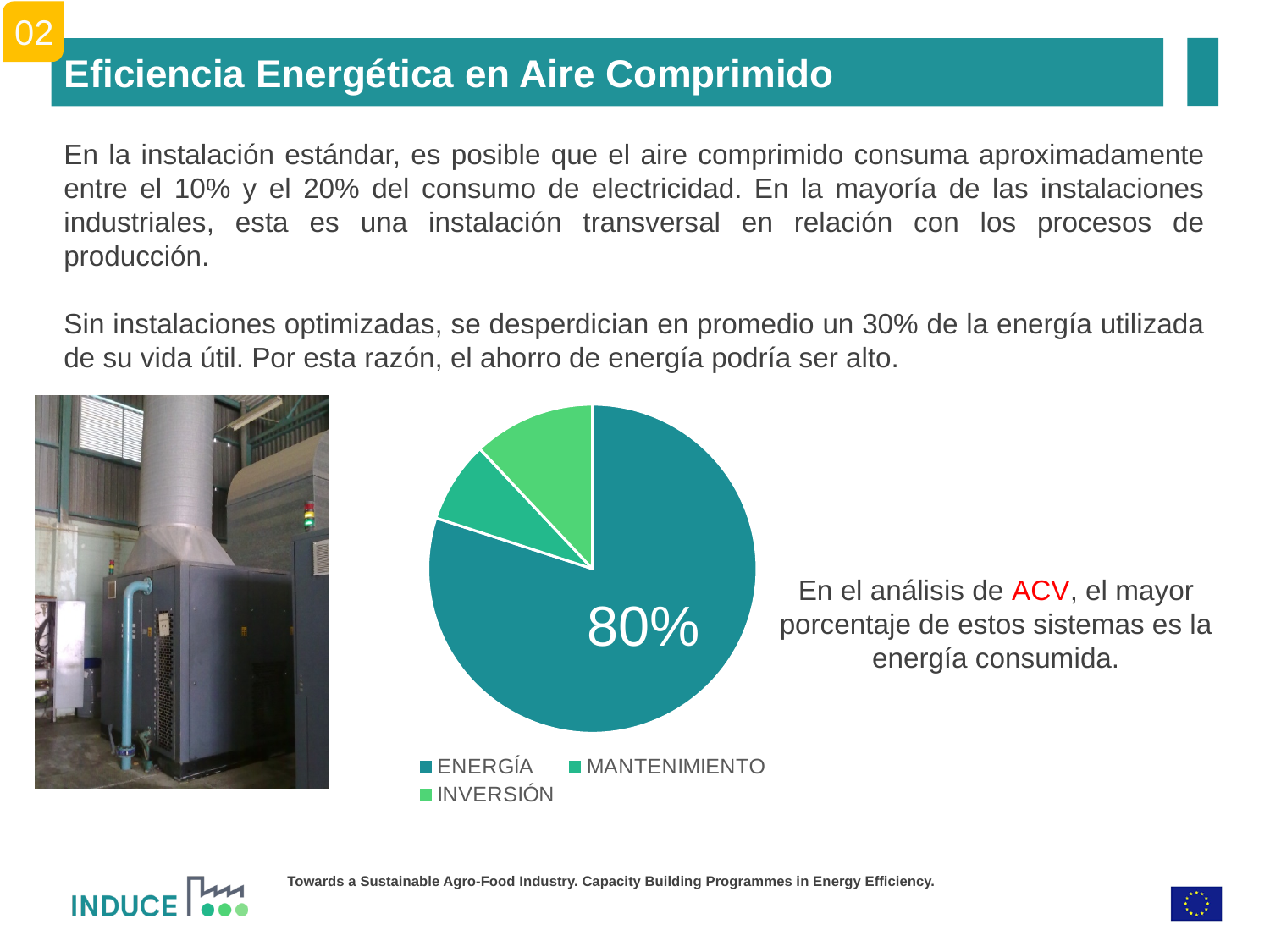
Which category has the largest slice in the pie chart? ENERGÍA What share of the pie does the ENERGÍA slice represent? 80% How many entries does the legend of the pie chart list? 3 How many slices does the pie chart have? 3 Which slice is larger in the pie chart, MANTENIMIENTO or INVERSIÓN? INVERSIÓN What kind of chart is shown on the slide? pie chart What colour is the ENERGÍA slice in the pie chart? dark teal What are the three categories listed in the pie chart legend? ENERGÍA, MANTENIMIENTO, INVERSIÓN Which category has the smallest slice in the pie chart? MANTENIMIENTO What percentage is shown for ENERGÍA in the pie chart? 80%